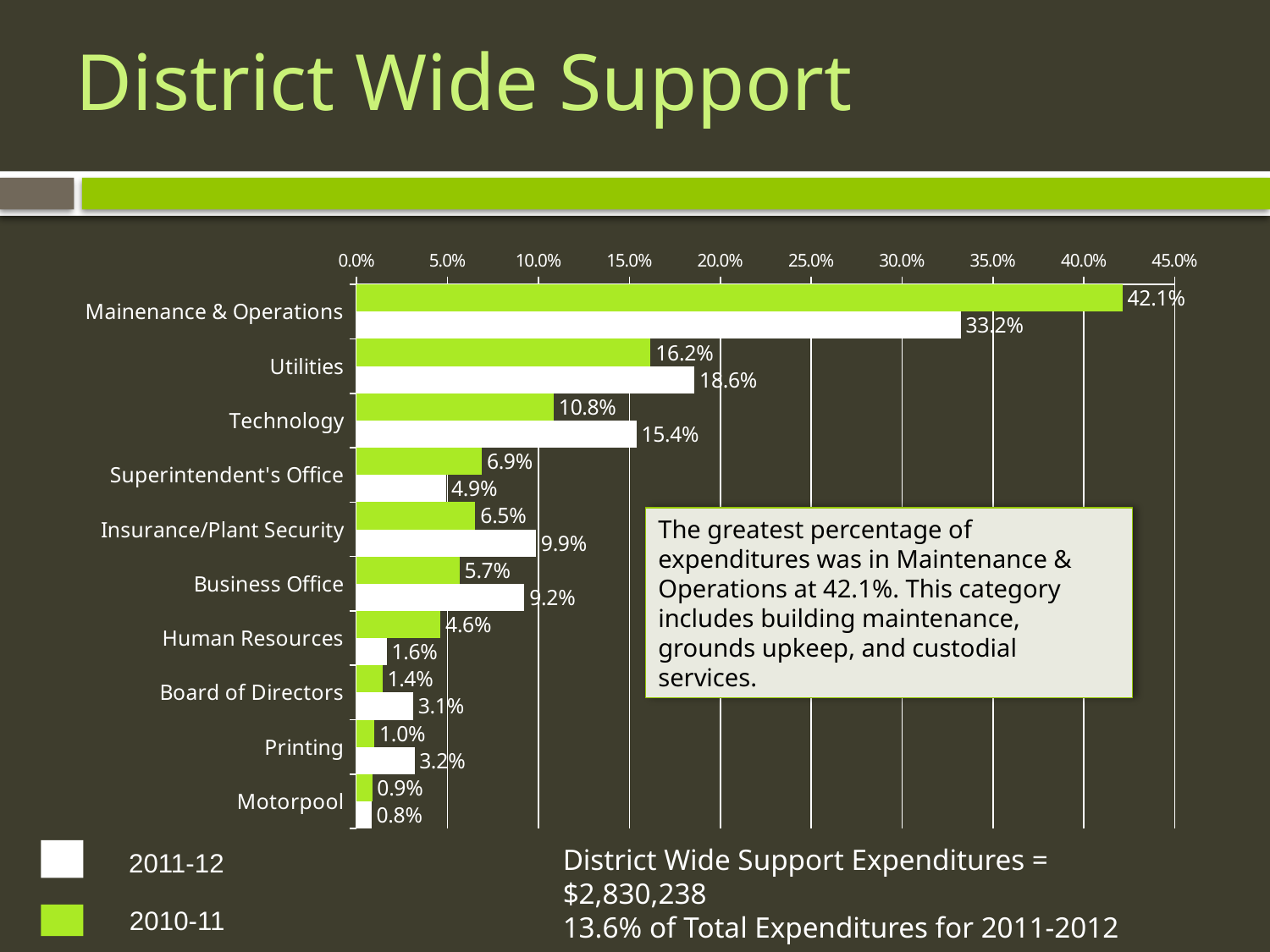
Which category has the lowest 2010-11 value? Motorpool What is the 2011-12 value for Technology? 15.4% Which is larger for Insurance/Plant Security, the 2011-12 value or the 2010-11 value? 2011-12 What is the difference between the 2010-11 and 2011-12 values for Maintenance & Operations? 8.9% What is the 2010-11 value for Maintenance & Operations? 42.1% Which series is shown in green according to the legend? 2010-11 What is the 2010-11 value for Human Resources? 4.6% Which category has the highest 2011-12 value? Maintenance & Operations What is the 2011-12 value for Utilities? 18.6% What type of chart is shown on the slide? bar chart How many categories are shown on the chart? 10 How many series does the legend list? 2